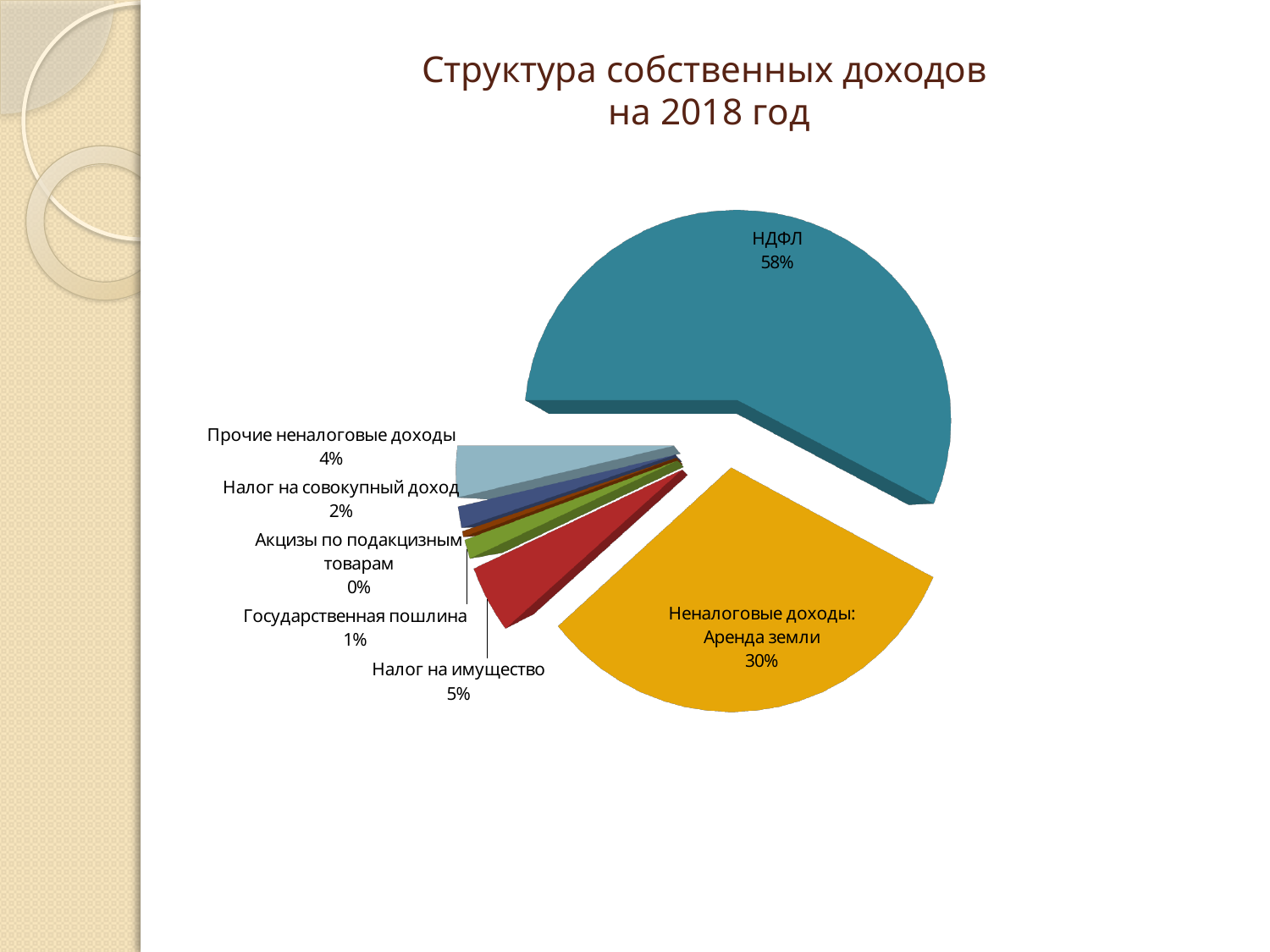
Which category has the largest slice of the pie? НДФЛ What share of the pie does Прочие неналоговые доходы have? 4% What share of the pie does Налог на совокупный доход have? 2% What kind of chart is shown on the slide? Pie chart Which category has the smallest slice of the pie? Акцизы по подакцизным товарам What share of the pie does Неналоговые доходы: Аренда земли have? 30% What share of the pie does Налог на имущество have? 5% What share of the pie does Государственная пошлина have? 1% Which is larger, Налог на имущество or Прочие неналоговые доходы? Налог на имущество How many slices does the pie chart have? 7 What share of the pie does НДФЛ have? 58% What is the difference in percentage points between НДФЛ and Неналоговые доходы: Аренда земли? 28